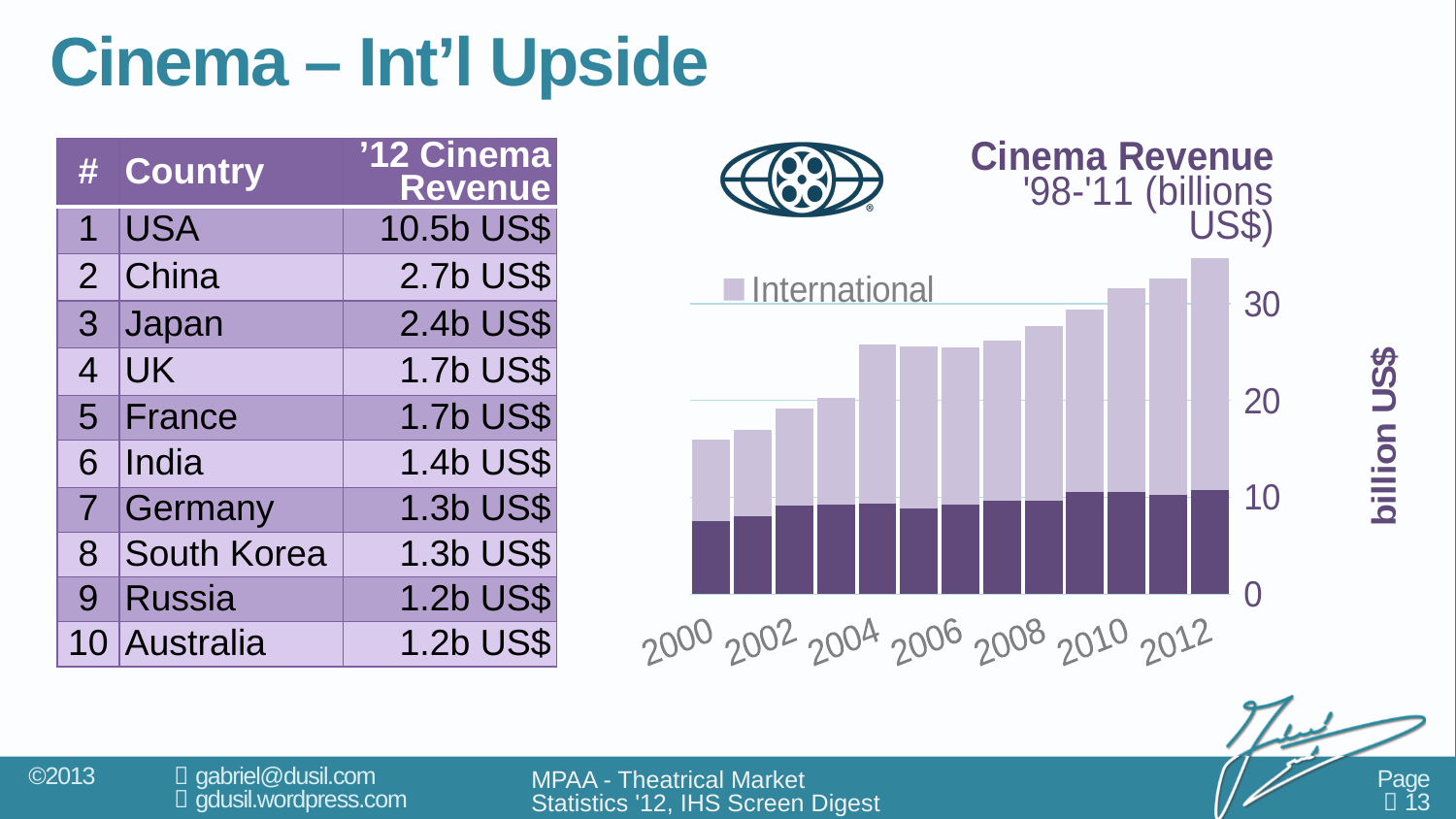
What entry does the legend of the Cinema Revenue chart show? International In the Cinema Revenue chart, is the dark (bottom) segment for 2000 greater or less than 10? less In the Cinema Revenue chart, is the total bar for 2012 greater or less than 30? greater What is the label on the vertical axis of the Cinema Revenue chart? billion US$ What kind of chart is shown on the right of the slide? stacked bar chart In the Cinema Revenue chart, which total bar is larger, 2000 or 2012? 2012 In the Cinema Revenue chart, which year has the lowest total bar? 2000 In the Cinema Revenue chart, is the total bar for 2004 greater or less than 20? greater How many bars (years) are plotted in the Cinema Revenue chart? 13 In the Cinema Revenue chart, which year has the highest total bar? 2012 In the Cinema Revenue chart, do total revenues generally rise or fall from 2000 to 2012? rise